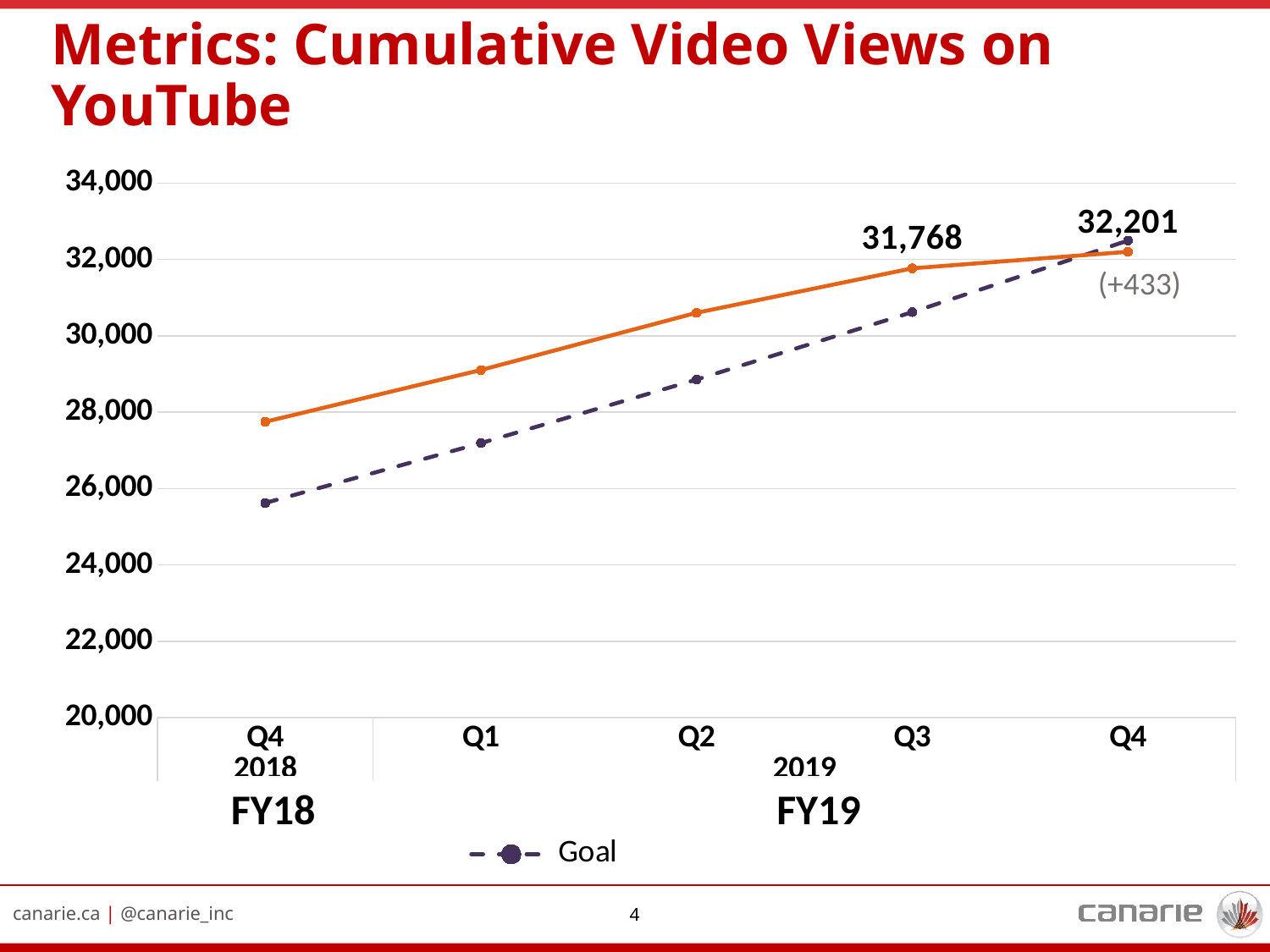
Which quarter has the lowest value on the dashed Goal line? Q4 2018 What is the cumulative video views value shown for Q4 2019 on the solid orange line? 32,201 What is the cumulative video views value shown for Q3 2019 on the solid orange line? 31,768 At Q3 2019, which is larger: the solid orange line value or the Goal value? The solid orange line value Do the values on the solid orange line rise or fall from Q4 2018 to Q4 2019? Rise How many series does the legend list? 1 Is the Goal value for Q4 2018 greater or less than 26,000? less What kind of chart is shown on the slide? Line chart How many quarters are plotted along the x axis? 5 Is the value on the solid orange line for Q2 2019 greater or less than 30,000? greater By how much did the value on the solid orange line increase from Q3 2019 to Q4 2019? 433 Which quarter has the highest value on the solid orange line? Q4 2019